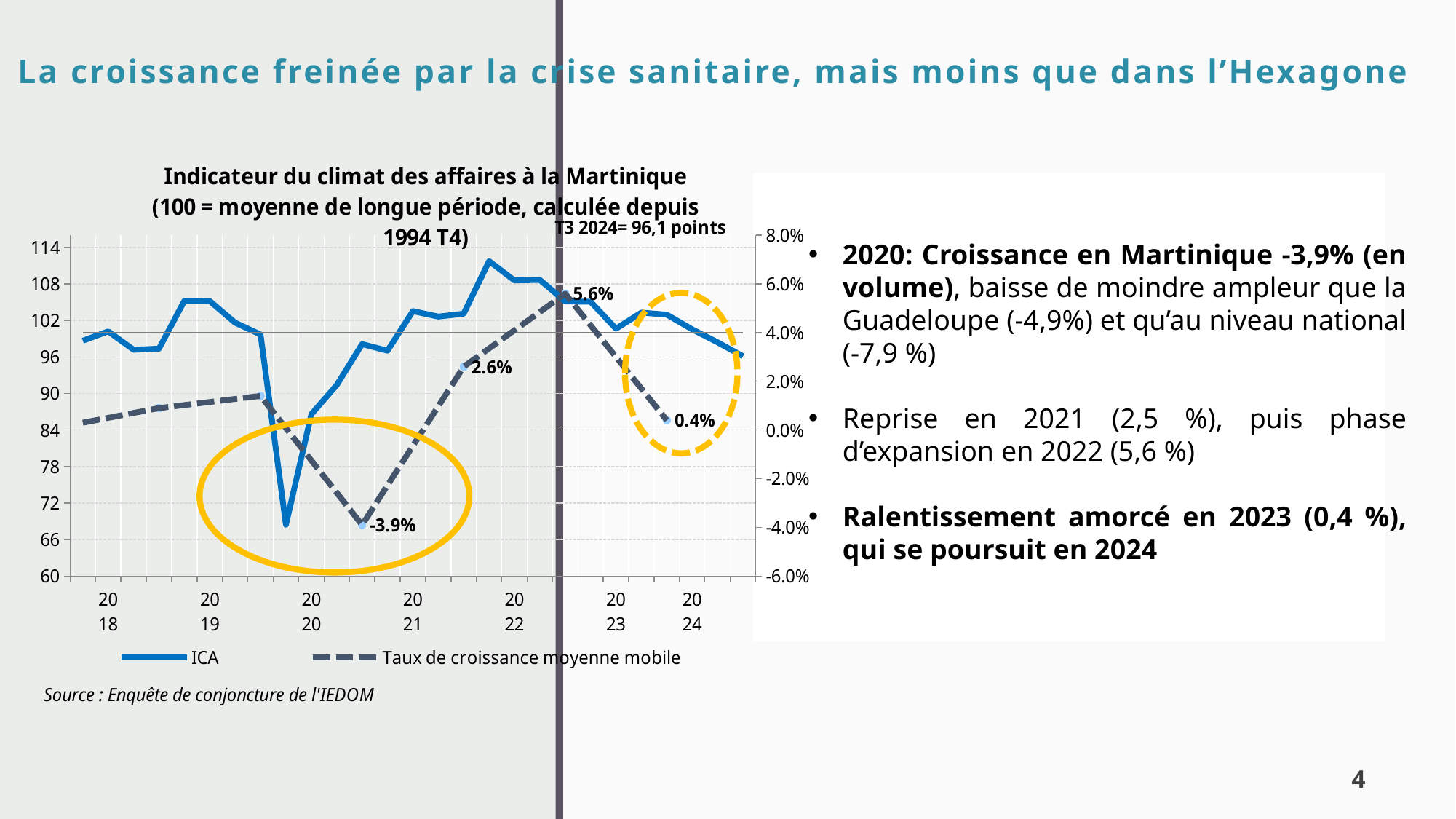
What is the difference between the labelled growth rate values 5.6% and 2.6%? 3.0 percentage points According to the annotation on the chart, what is the ICA value for T3 2024? 96,1 points What are the two series named in the chart legend? ICA and Taux de croissance moyenne mobile What is the lowest labelled value of the Taux de croissance moyenne mobile series? -3.9% Which labelled growth rate value is larger: the one for 2021 or the one for 2022? 2022 (5.6%) Does the Taux de croissance moyenne mobile series rise or fall between its 2022 label and its 2023 label? Fall What is the highest labelled value of the Taux de croissance moyenne mobile series? 5.6% What is the labelled value of the Taux de croissance moyenne mobile series in 2021? 2.6% How many series does the chart legend list? 2 What is the labelled value of the Taux de croissance moyenne mobile series in 2023? 0.4% What type of chart is shown on the slide? Line chart Is the lowest value of the ICA line greater or less than 72? less